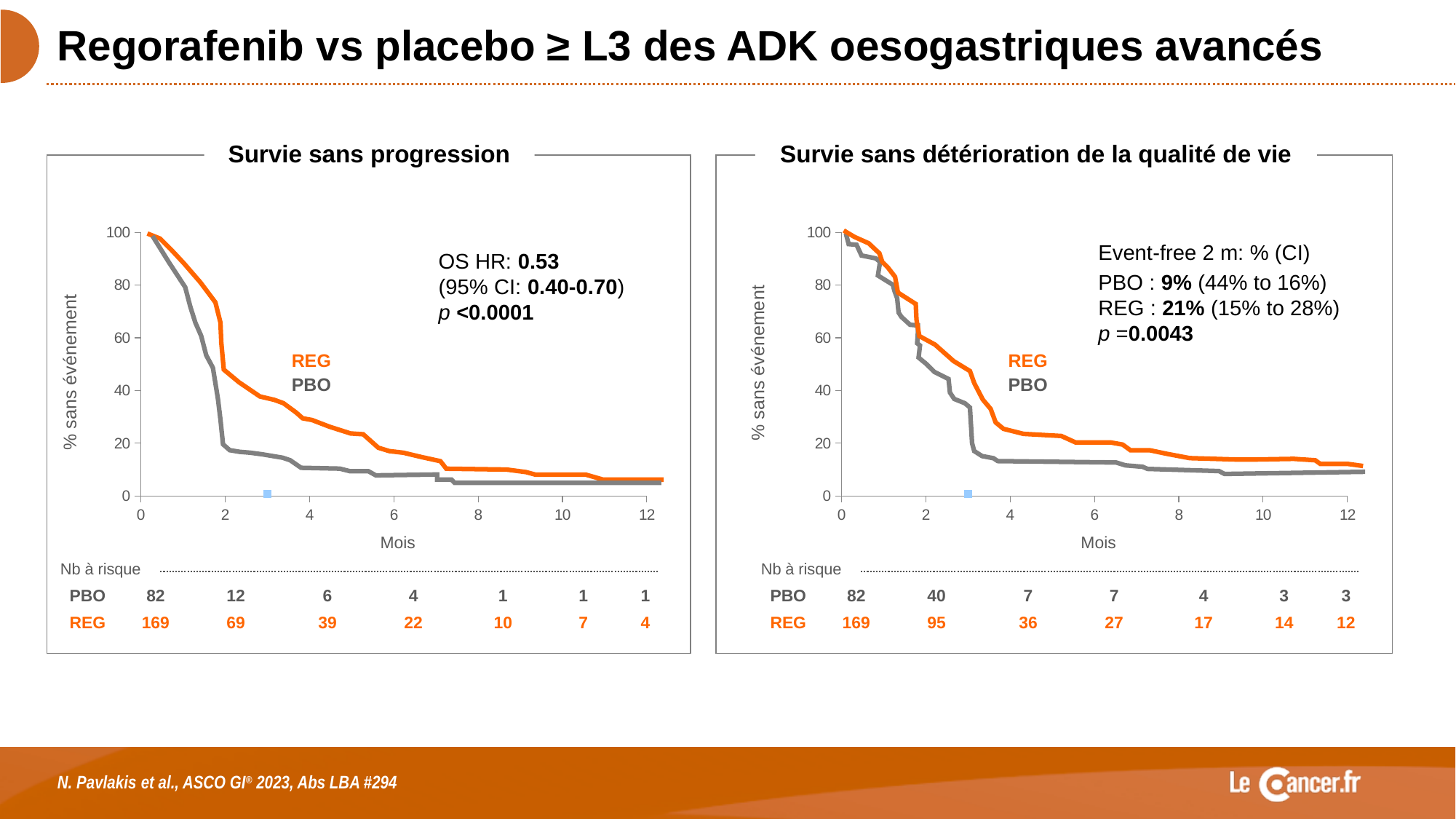
What kind of chart is the 'Survie sans progression' chart? line chart In the 'Survie sans progression' chart, how many PBO patients are at risk at 2 months? 12 In the 'Survie sans progression' chart, how many REG patients are at risk at 0 months? 169 In the 'Survie sans détérioration de la qualité de vie' chart, how many PBO patients are at risk at 2 months? 40 In the 'Survie sans détérioration de la qualité de vie' chart, do the curves rise or fall as months increase? fall In the 'Survie sans progression' chart, what is the OS hazard ratio shown? 0.53 In the 'Survie sans progression' chart, what is the 95% CI shown for the hazard ratio? 0.40-0.70 In the 'Survie sans détérioration de la qualité de vie' chart, what is the event-free rate at 2 months for REG? 21% In the 'Survie sans progression' chart, is the REG curve at 4 months greater or less than 40%? less In the 'Survie sans détérioration de la qualité de vie' chart, what is the p-value shown? 0.0043 In the 'Survie sans progression' chart, how many series (groups) are plotted? 2 In the 'Survie sans progression' chart, which curve is higher at 6 months, REG or PBO? REG